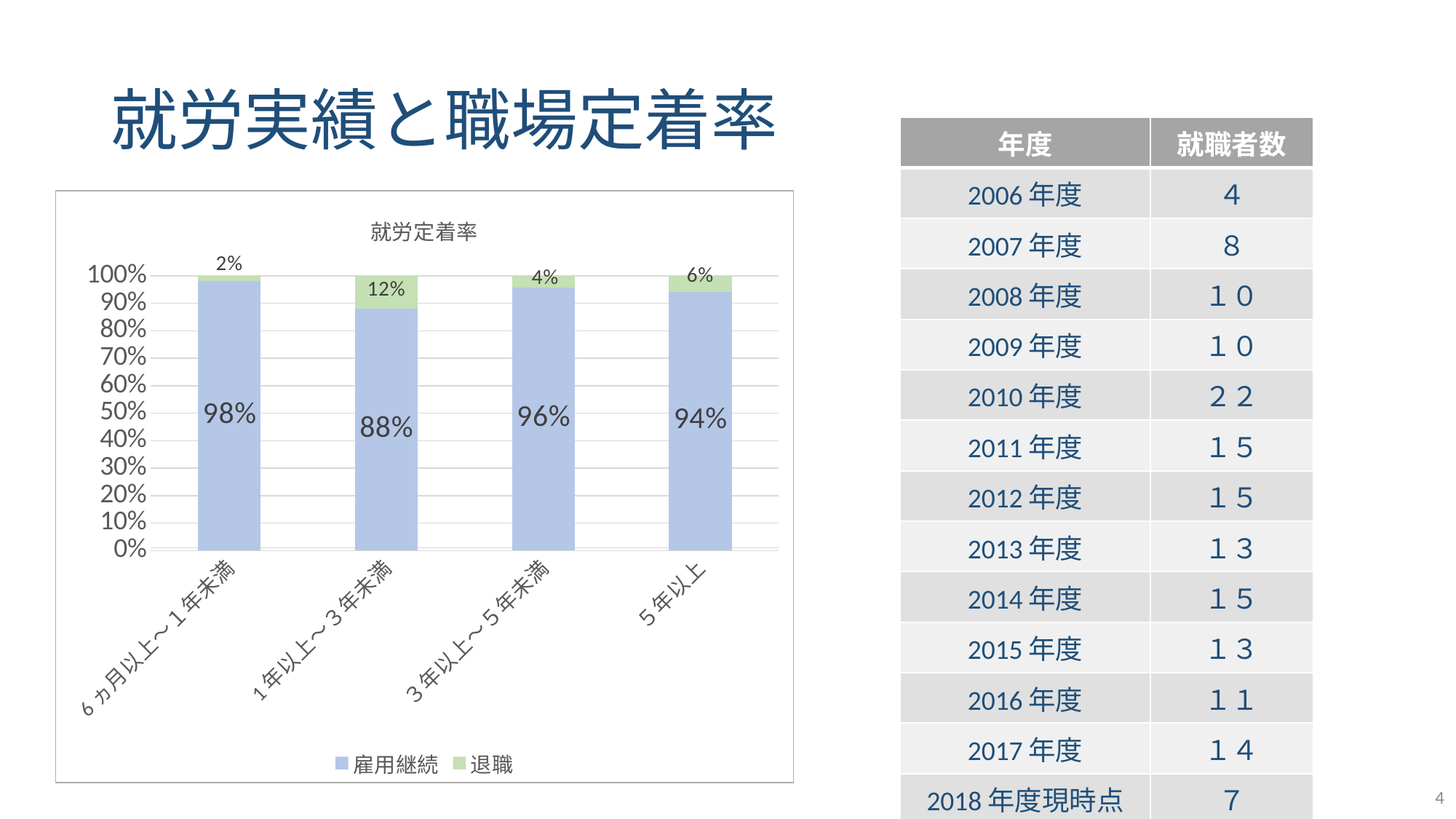
What is the difference between the 雇用継続 values for 6カ月以上～1年未満 and 1年以上～3年未満? 10% Which is larger, the 退職 value for 5年以上 or for 3年以上～5年未満? 5年以上 What is the value of 雇用継続 for the 5年以上 category? 94% What kind of chart is shown on the slide? Stacked bar chart How many categories are shown on the x axis of the chart? 4 What is the value of 退職 for the 1年以上～3年未満 category? 12% What is the value of 雇用継続 for the 6カ月以上～1年未満 category? 98% Which category has the lowest 雇用継続 value? 1年以上～3年未満 Which category has the highest 雇用継続 value? 6カ月以上～1年未満 What is the title of the chart? 就労定着率 What is the value of 退職 for the 3年以上～5年未満 category? 4% How many series does the chart legend list? 2